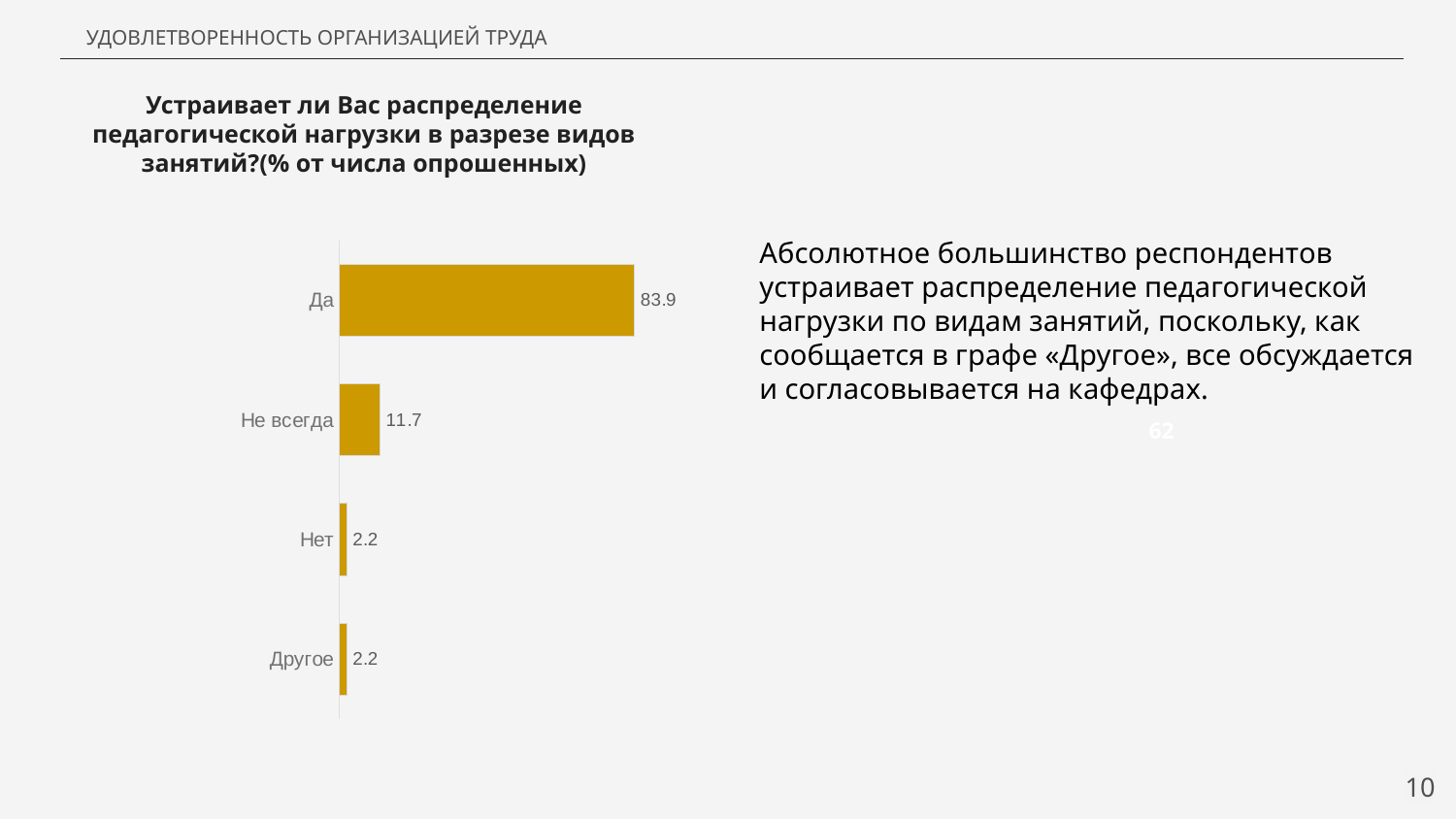
Which category has the highest value? Да What colour are the bars in the chart? gold (dark yellow) Which is larger, the value for "Да" or the value for "Не всегда"? Да What is the value for "Нет"? 2.2 How many categories are shown in the chart? 4 What is the value for "Да"? 83.9 What is the total of the values for "Нет" and "Другое"? 4.4 What is the value for "Другое"? 2.2 What is the difference between the values for "Не всегда" and "Нет"? 9.5 What is the value for "Не всегда"? 11.7 What kind of chart is shown on the slide? bar chart What is the difference between the values for "Да" and "Не всегда"? 72.2